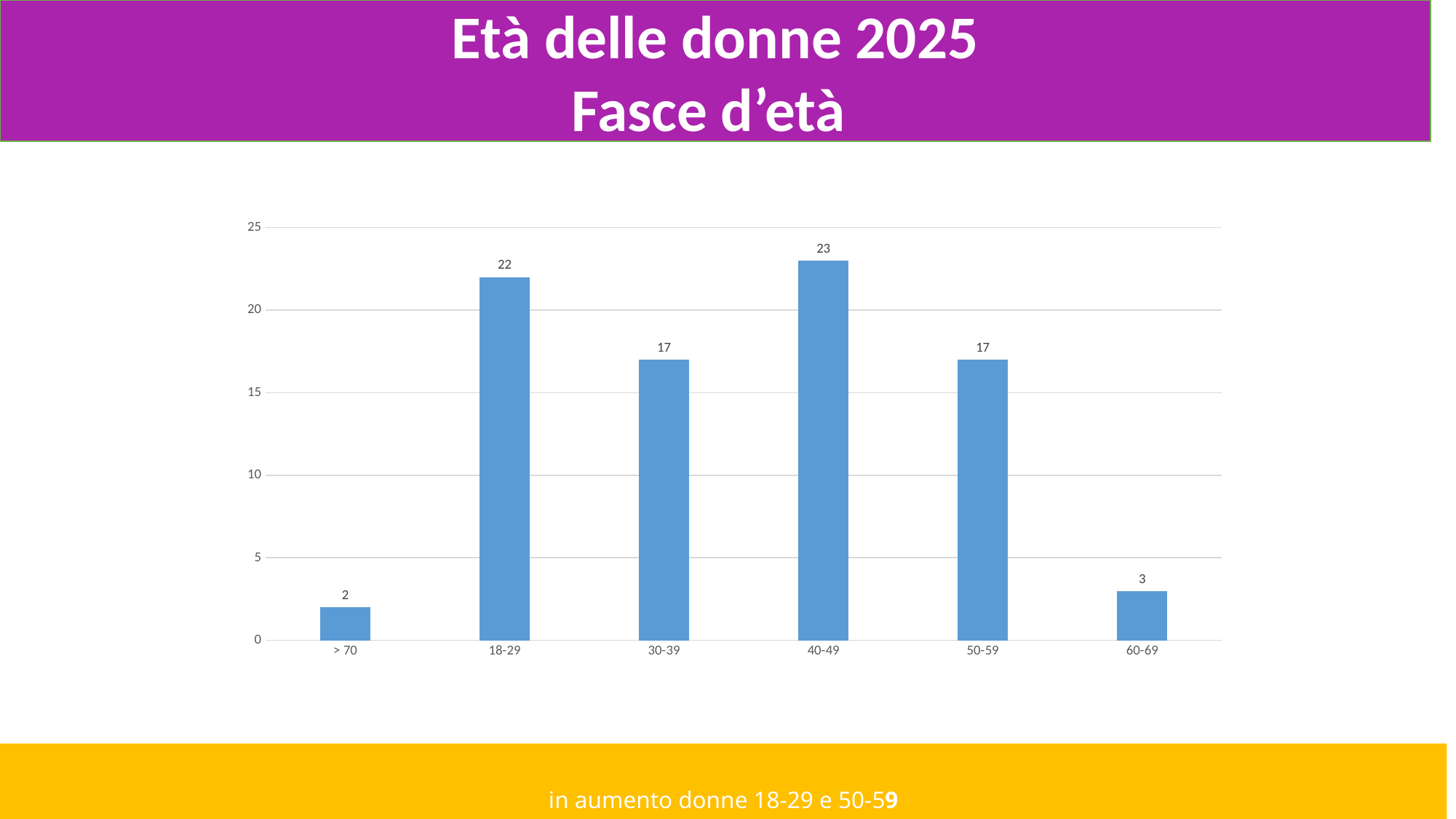
What is the value for the 18-29 age group? 22 What is the value for the 40-49 age group? 23 What is the difference between the values for 40-49 and 18-29? 1 Which age group has the lowest value? > 70 What kind of chart is shown on the slide? bar chart What is the value for the 60-69 age group? 3 What is the difference between the values for 18-29 and 30-39? 5 Which age group has the highest value? 40-49 How many age groups are shown on the x axis? 6 What is the value for the > 70 age group? 2 Which is larger, the value for 18-29 or the value for 50-59? 18-29 Is the value for 30-39 greater or less than 15? greater